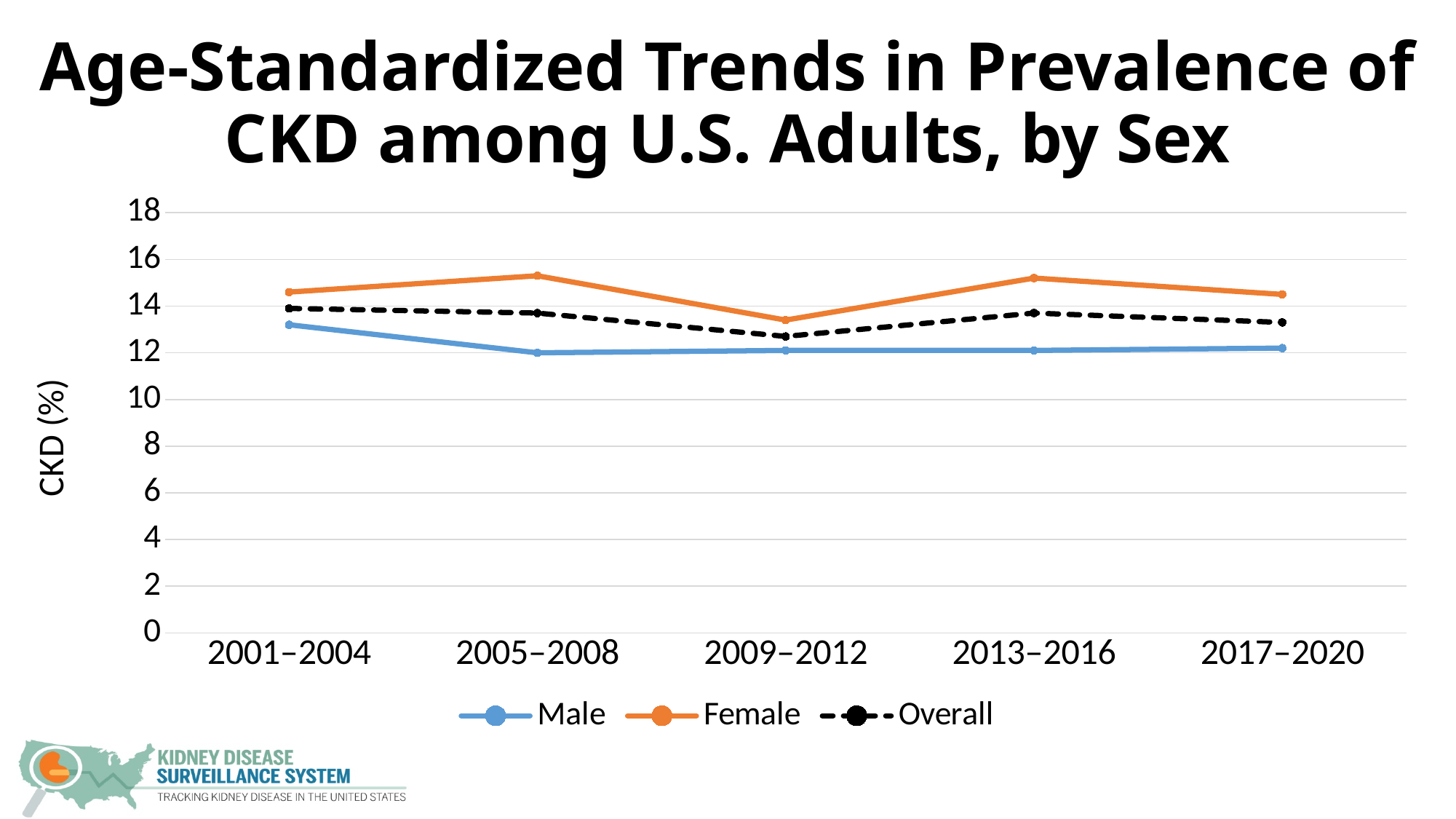
Is the value for Male in 2005–2008 greater or less than 14? less Which series has the higher value in 2005–2008, Male or Female? Female How many series does the legend list? 3 What kind of chart is shown on the slide? line chart In which time period is the Male series at its highest? 2001–2004 Is the value for Female in 2005–2008 greater or less than 14? greater Does the Male series rise or fall from 2001–2004 to 2005–2008? fall Which series is drawn with a dashed line? Overall In which time period is the Female series at its lowest? 2009–2012 In which time period is the Overall series at its lowest? 2009–2012 How many time periods are shown on the x axis? 5 Which series has the higher value in 2017–2020, Overall or Male? Overall